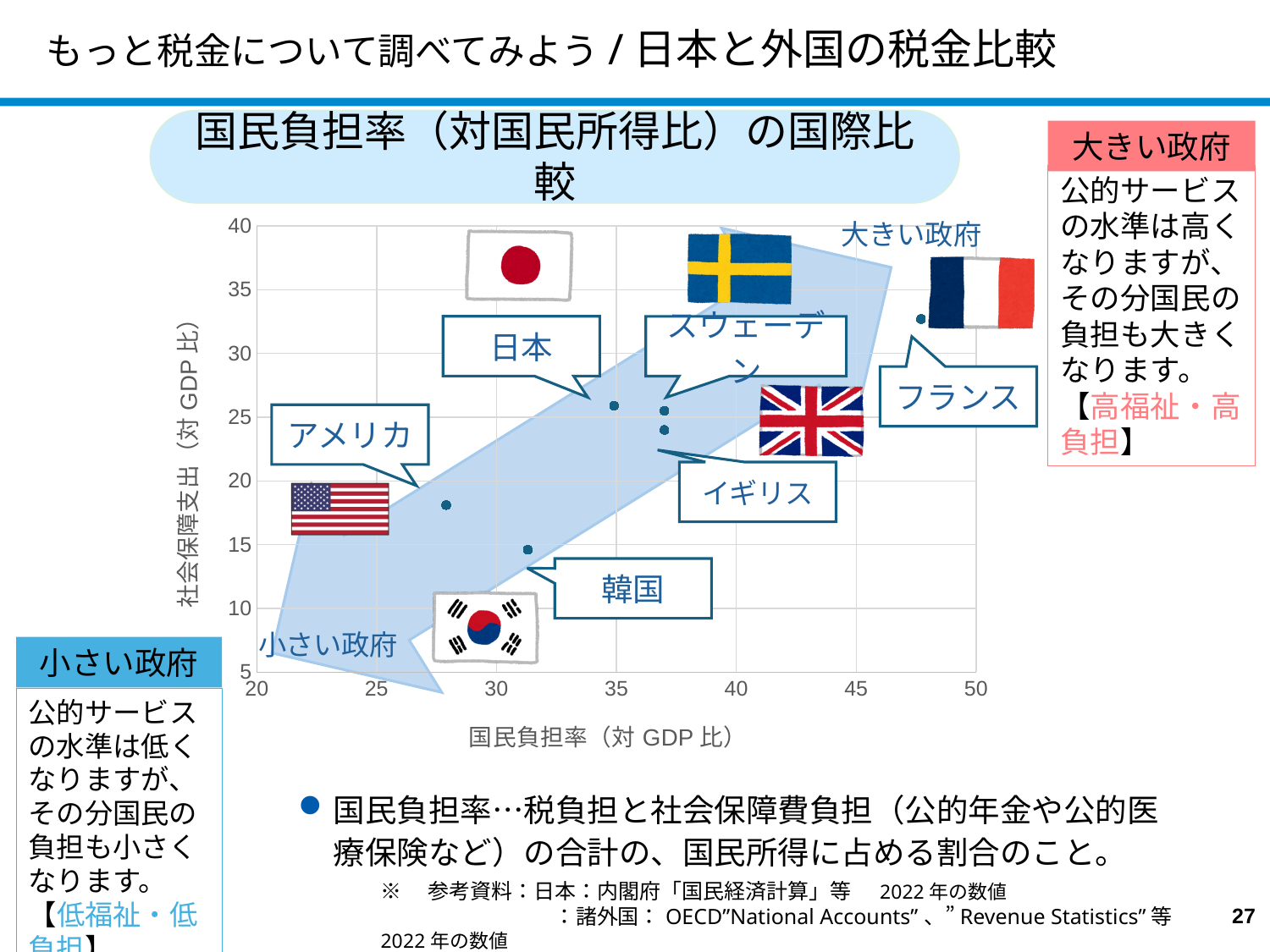
Which country has the lowest 国民負担率 (x-axis value) in the chart? アメリカ Is the 国民負担率 (x-axis value) for アメリカ greater or less than 30? less Is the 社会保障支出 (y-axis value) for 韓国 greater or less than 20? less Which country has the highest 国民負担率 (x-axis value) in the chart? フランス How many countries are plotted in the chart? 6 What is the label of the x axis of the chart? 国民負担率（対 GDP 比） Do the plotted points generally rise or fall as 国民負担率 increases along the x axis? rise Which has the higher 社会保障支出 (y-axis value), 日本 or アメリカ? 日本 Is the 社会保障支出 (y-axis value) for スウェーデン greater or less than 20? greater What kind of chart is shown on the slide? scatter chart Which country has the lowest 社会保障支出 (y-axis value) in the chart? 韓国